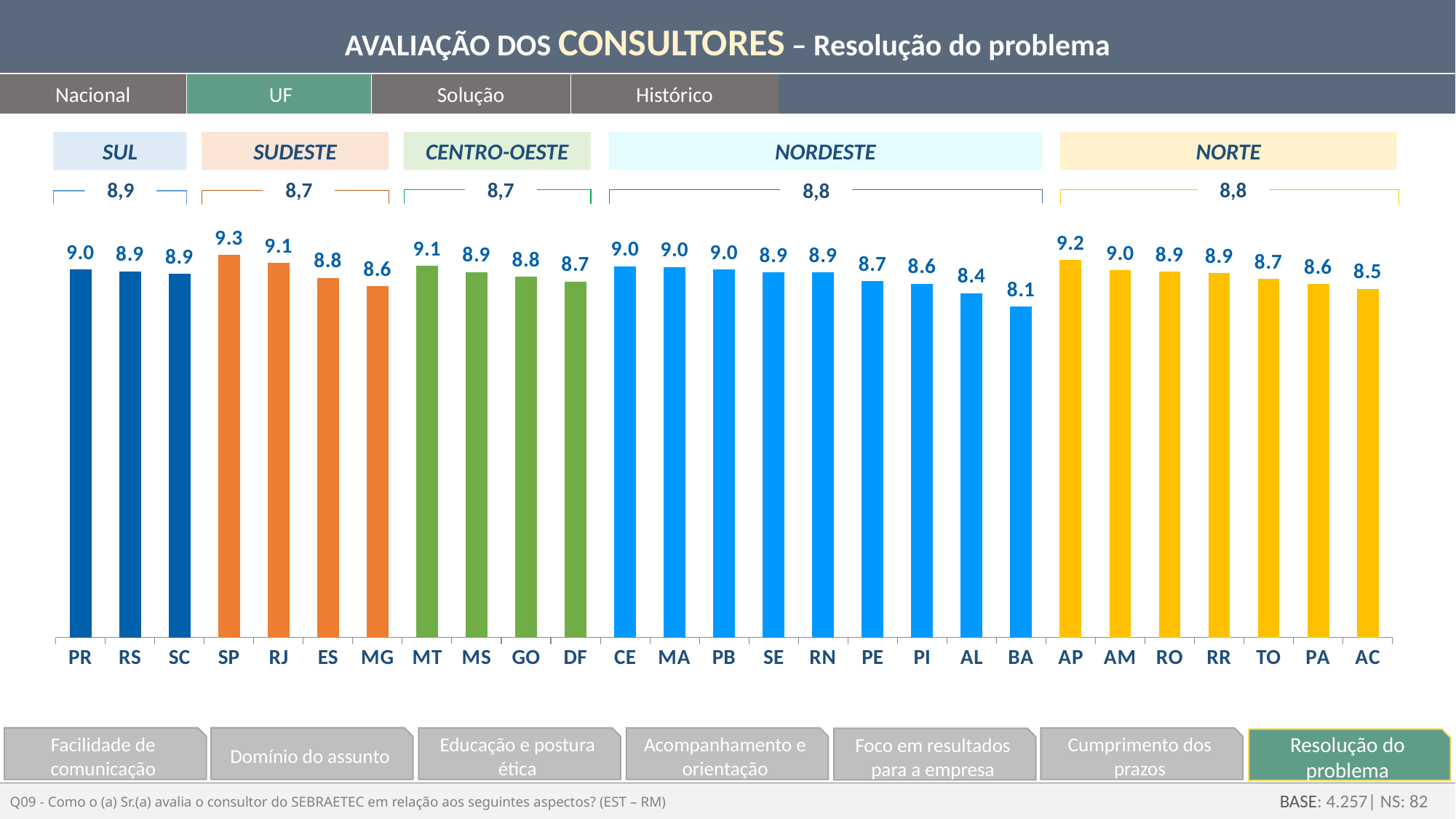
What is the difference between the values for AP and AC? 0.7 How many states (bars) are shown in the chart? 27 What is the difference between the values for SP and BA? 1.2 What is the value for AP? 9.2 What is the value for DF? 8.7 What kind of chart is shown on the slide? Bar chart Which is larger, the value for MT or the value for MG? MT Which state has the lowest value? BA Which state has the highest value? SP What is the regional average shown for SUL? 8,9 What is the value for BA? 8.1 What is the value for SP? 9.3